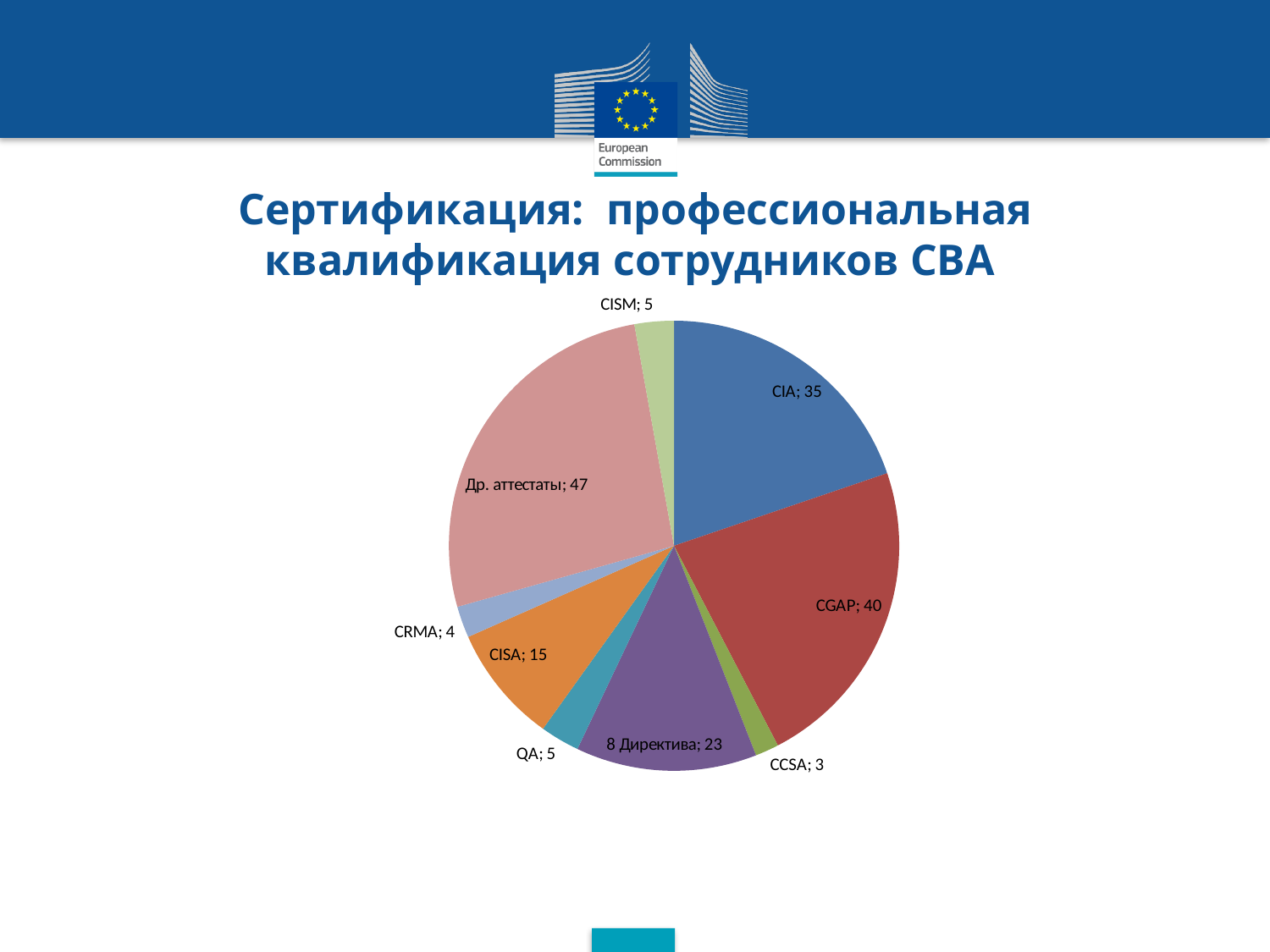
What is the value for CIA? 35 What kind of chart is shown on the slide? pie chart What is the total of all the values shown in the pie chart? 177 How many slices does the pie chart have? 9 What is the value for CGAP? 40 Which is larger, the value for CISA or the value for 8 Директива? 8 Директива Which category has the largest slice of the pie? Др. аттестаты What is the value for 8 Директива? 23 What is the value for CISA? 15 What is the value for CRMA? 4 What is the difference between the values for CGAP and CIA? 5 Which category has the smallest slice of the pie? CCSA